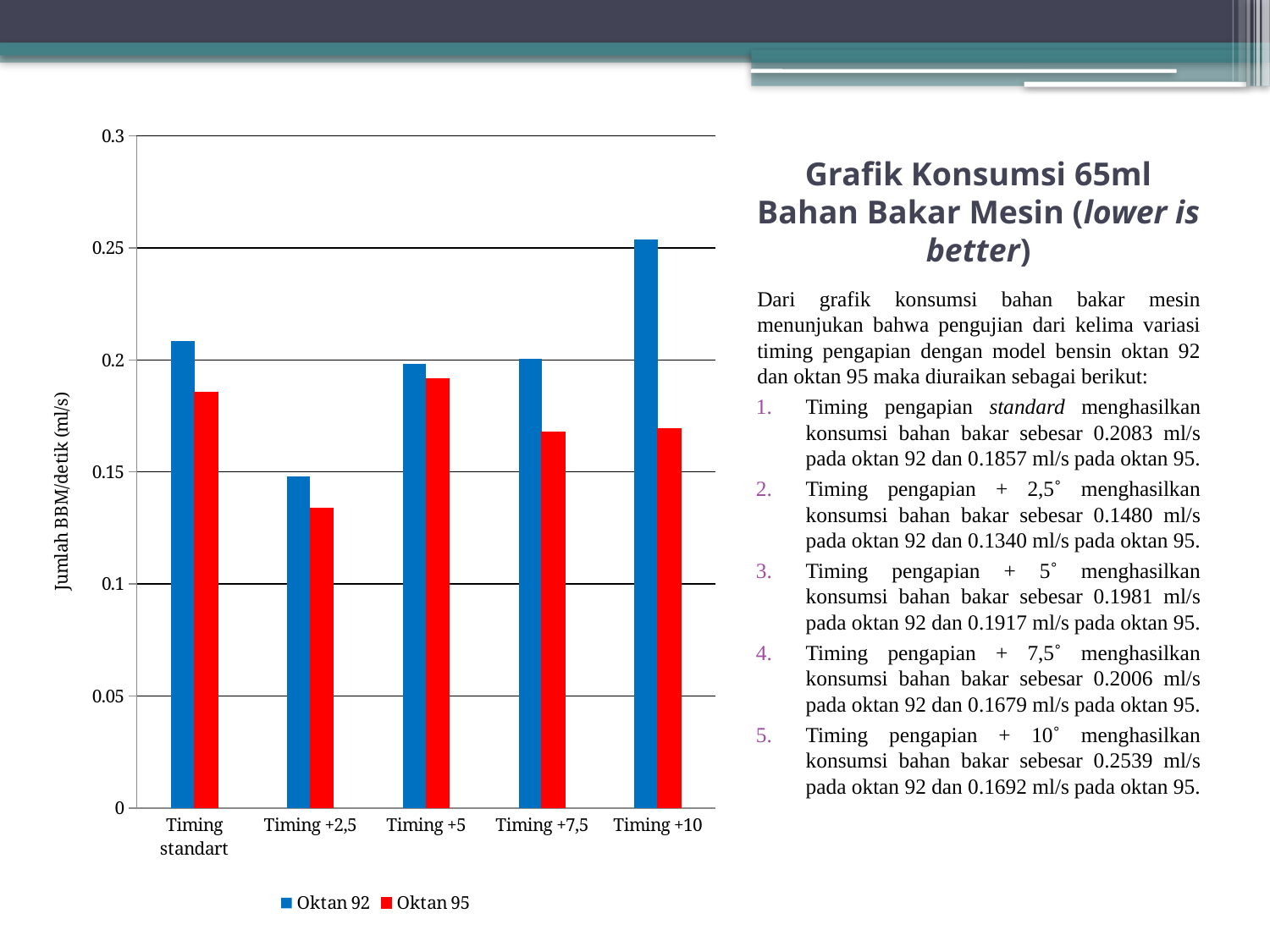
At Timing +7,5, which series has the larger value, Oktan 92 or Oktan 95? Oktan 92 For which timing category is the Oktan 92 bar the highest? Timing +10 Is the Oktan 95 value for Timing +7,5 greater or less than 0.15? greater How many series does the chart legend list? 2 For which timing category is the Oktan 92 bar the lowest? Timing +2,5 For which timing category is the Oktan 95 bar the lowest? Timing +2,5 Is the Oktan 92 value for Timing +2,5 greater or less than 0.15? less Is the Oktan 92 value for Timing standart greater or less than 0.2? greater What kind of chart is shown on the slide? Bar chart What is the label of the chart's vertical axis? Jumlah BBM/detik (ml/s) At Timing +10, which series has the larger value, Oktan 92 or Oktan 95? Oktan 92 How many timing categories are shown on the x axis of the chart? 5